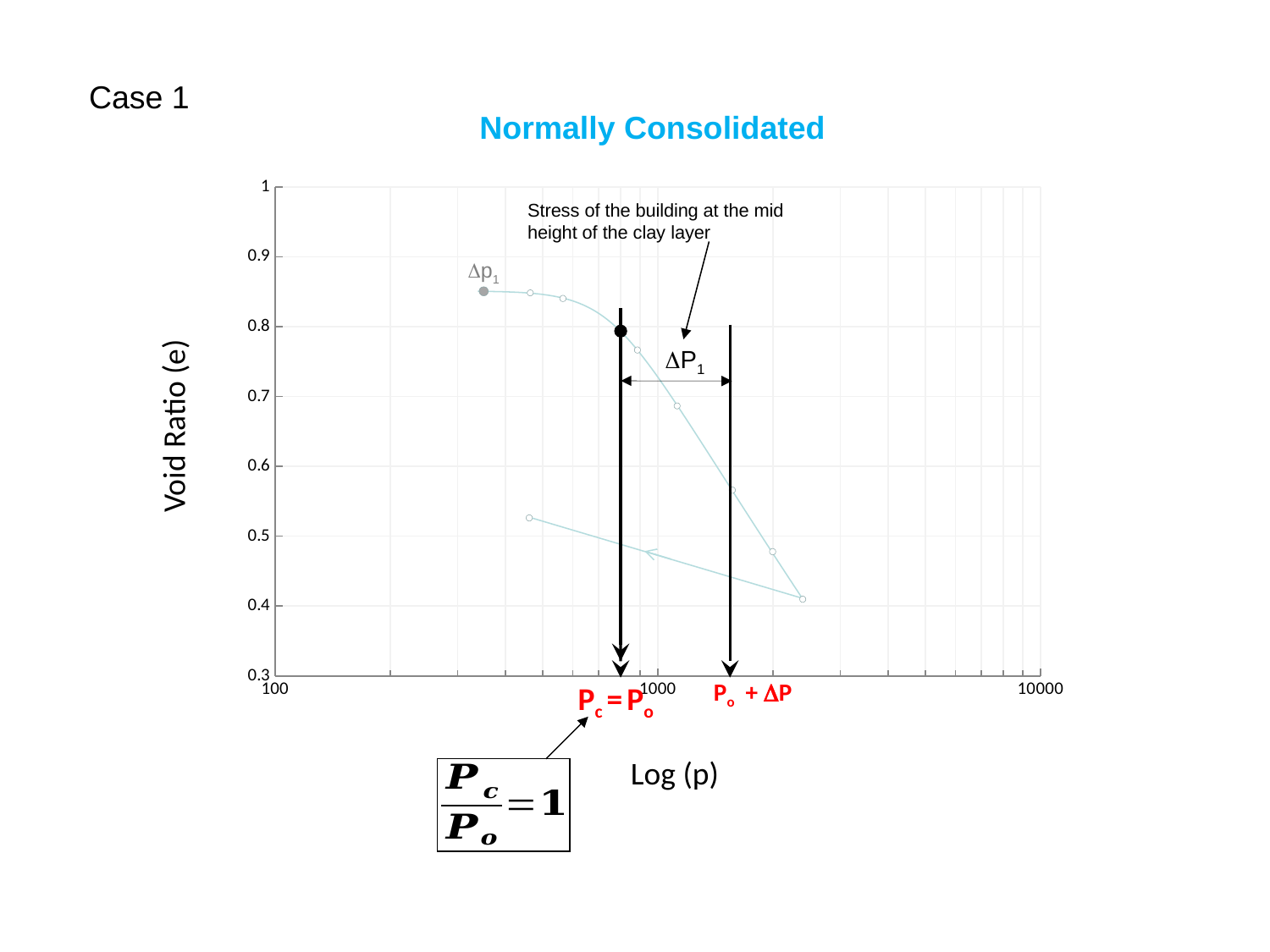
What is the lowest value shown on the vertical axis? 0.3 Does the void ratio rise or fall as Log (p) increases along the main consolidation curve? fall Is the void ratio at the point marked Po + ΔP greater or less than 0.7? less What is the highest value shown on the vertical axis? 1 Is the void ratio at the point marked Pc = Po greater or less than 0.7? greater Is the lowest void ratio reached by the curve greater or less than 0.5? less What kind of chart is shown on the slide? line chart What is the title of the chart? Normally Consolidated Which point has the higher void ratio: the one at Pc = Po or the one at Po + ΔP? Pc = Po